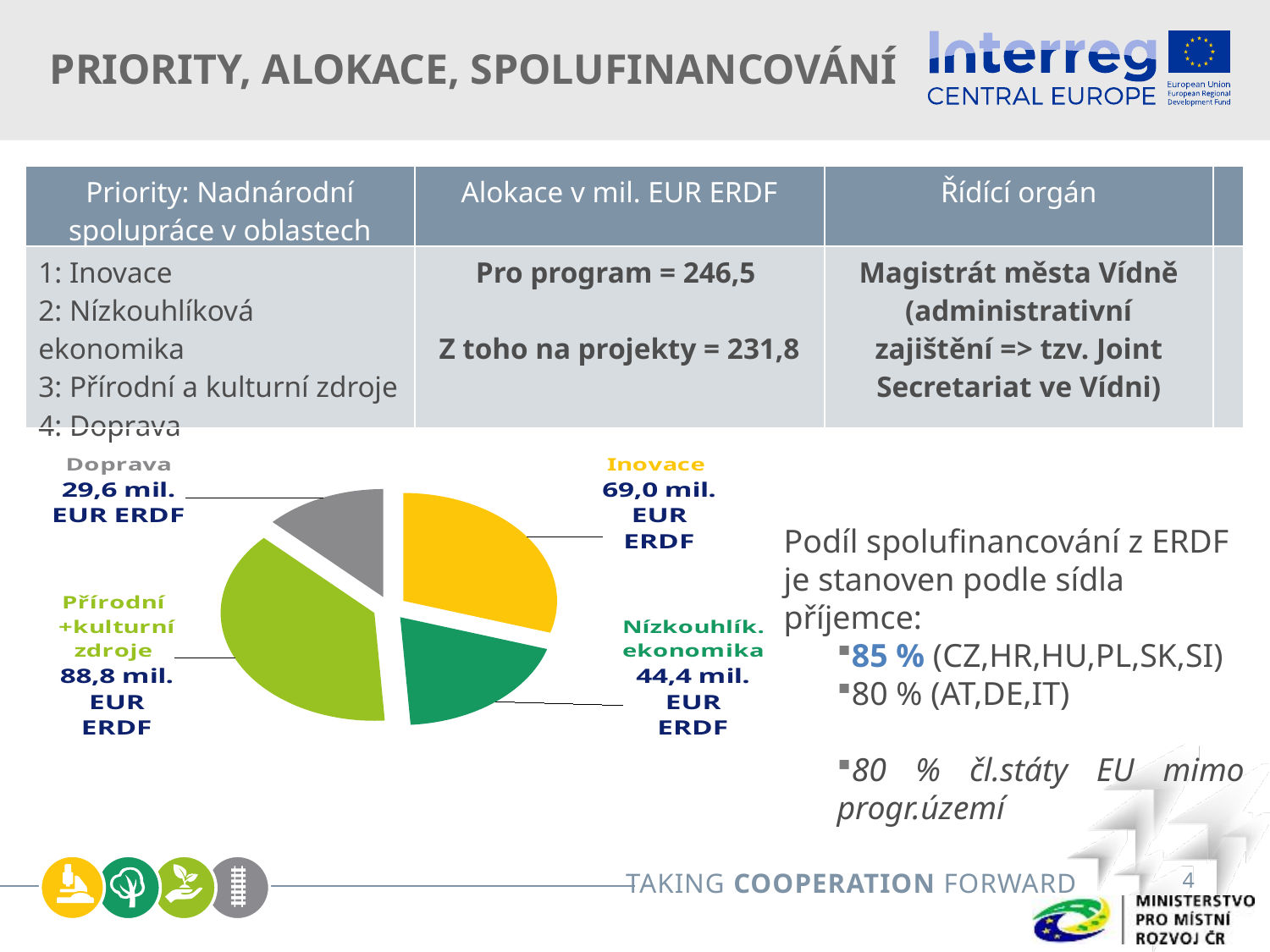
What is the value shown for Nízkouhlík. ekonomika in the pie chart? 44,4 mil. EUR ERDF What is the difference in mil. EUR ERDF between Inovace and Nízkouhlík. ekonomika? 24,6 Which slice of the pie chart has the smallest value? Doprava What is the value shown for Inovace in the pie chart? 69,0 mil. EUR ERDF How many slices does the pie chart have? 4 What colour is the Doprava slice in the pie chart? Grey Which slice of the pie chart has the largest value? Přírodní+kulturní zdroje What is the value shown for Doprava in the pie chart? 29,6 mil. EUR ERDF What type of chart is shown on the slide? Pie chart What is the difference in mil. EUR ERDF between Přírodní+kulturní zdroje and Inovace? 19,8 What is the value shown for Přírodní+kulturní zdroje in the pie chart? 88,8 mil. EUR ERDF Which is larger in the pie chart, Nízkouhlík. ekonomika or Doprava? Nízkouhlík. ekonomika